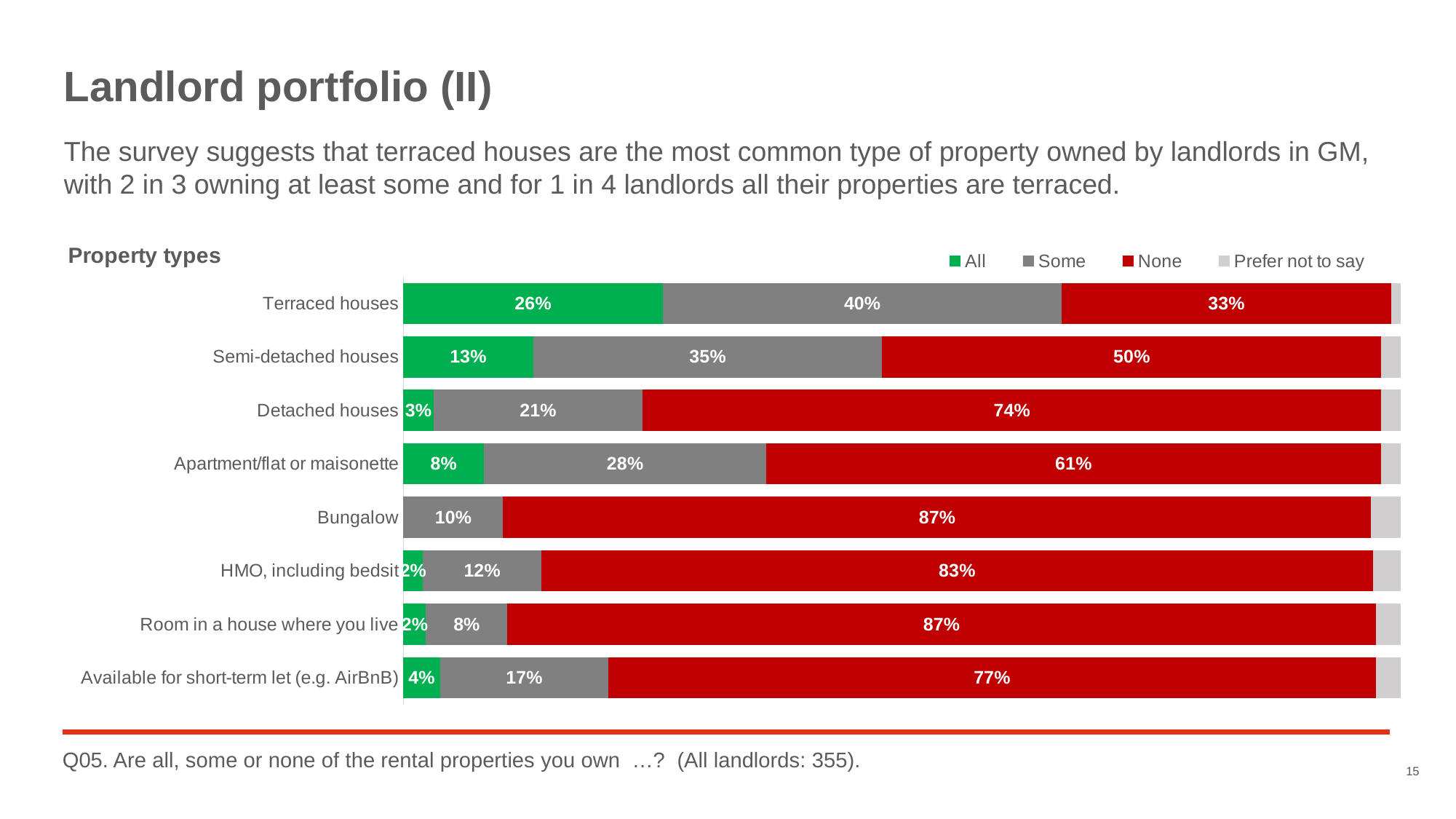
How many series does the legend list? 4 Which property type has the highest 'All' value? Terraced houses What percentage of landlords said none of their properties are detached houses? 74% Which has a larger 'Some' value: apartment/flat or maisonette, or detached houses? Apartment/flat or maisonette What is the 'Some' value for terraced houses? 40% Which colour represents 'None' in the chart? Red What is the difference between the 'None' values for semi-detached houses and terraced houses? 17 percentage points Which property type has the lowest 'None' value? Terraced houses What is the 'All' value for semi-detached houses? 13% What kind of chart is shown on the slide? Stacked bar chart What is the difference between the 'Some' values for terraced houses and bungalows? 30 percentage points How many property types are shown in the chart? 8